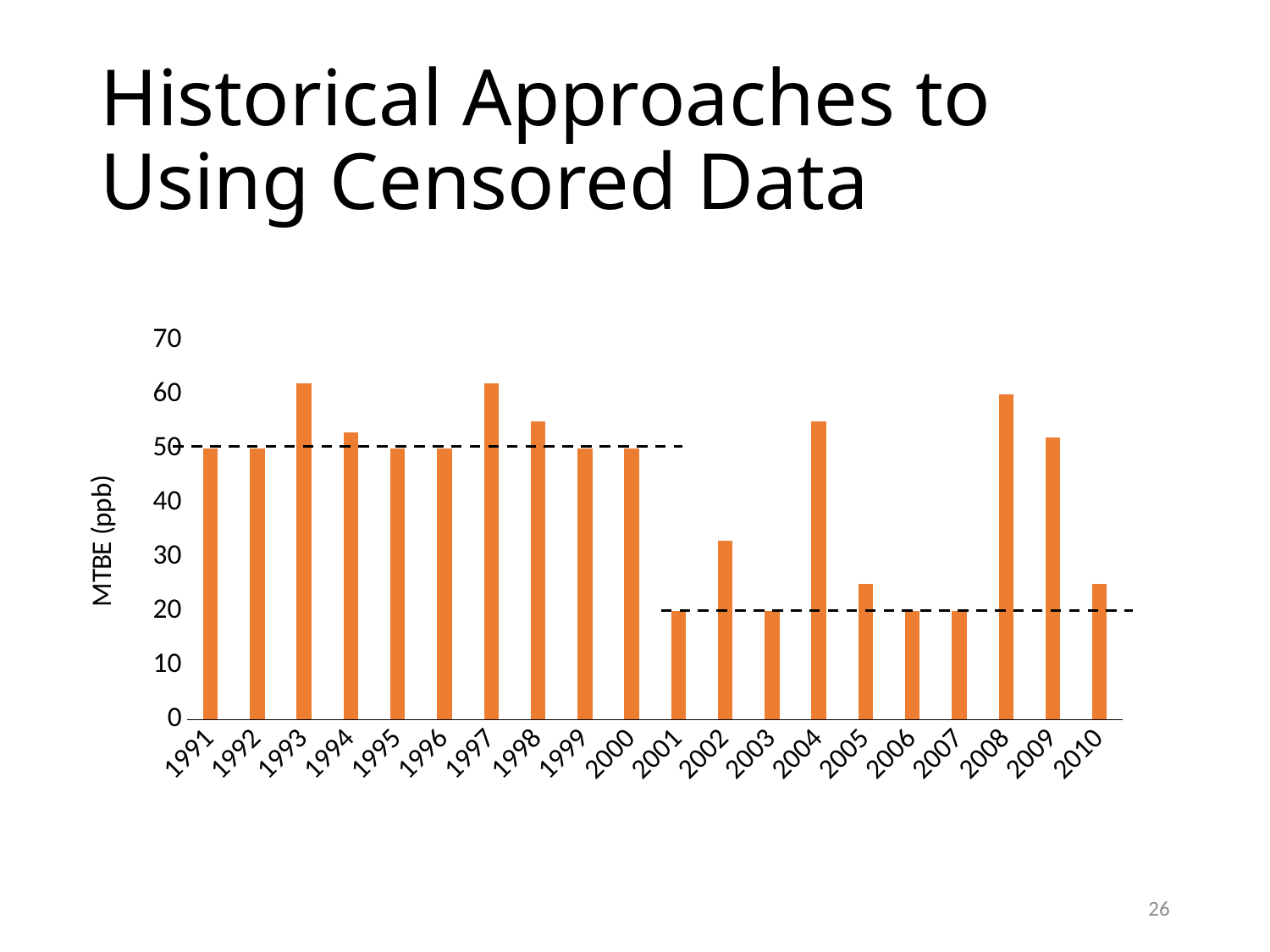
What is the MTBE value for 1991? 50 What is the MTBE value for 2006? 20 What kind of chart is shown on the slide? bar chart Is the value for 2004 greater or less than 50? greater Which year has the larger value, 2004 or 2005? 2004 How many years are shown on the x axis of the chart? 20 Is the value for 2002 greater or less than 30? greater Is the value for 1993 greater or less than 50? greater What is the label of the vertical axis of the chart? MTBE (ppb) Which year has the larger value, 1993 or 2002? 1993 What is the first year on the x axis of the chart? 1991